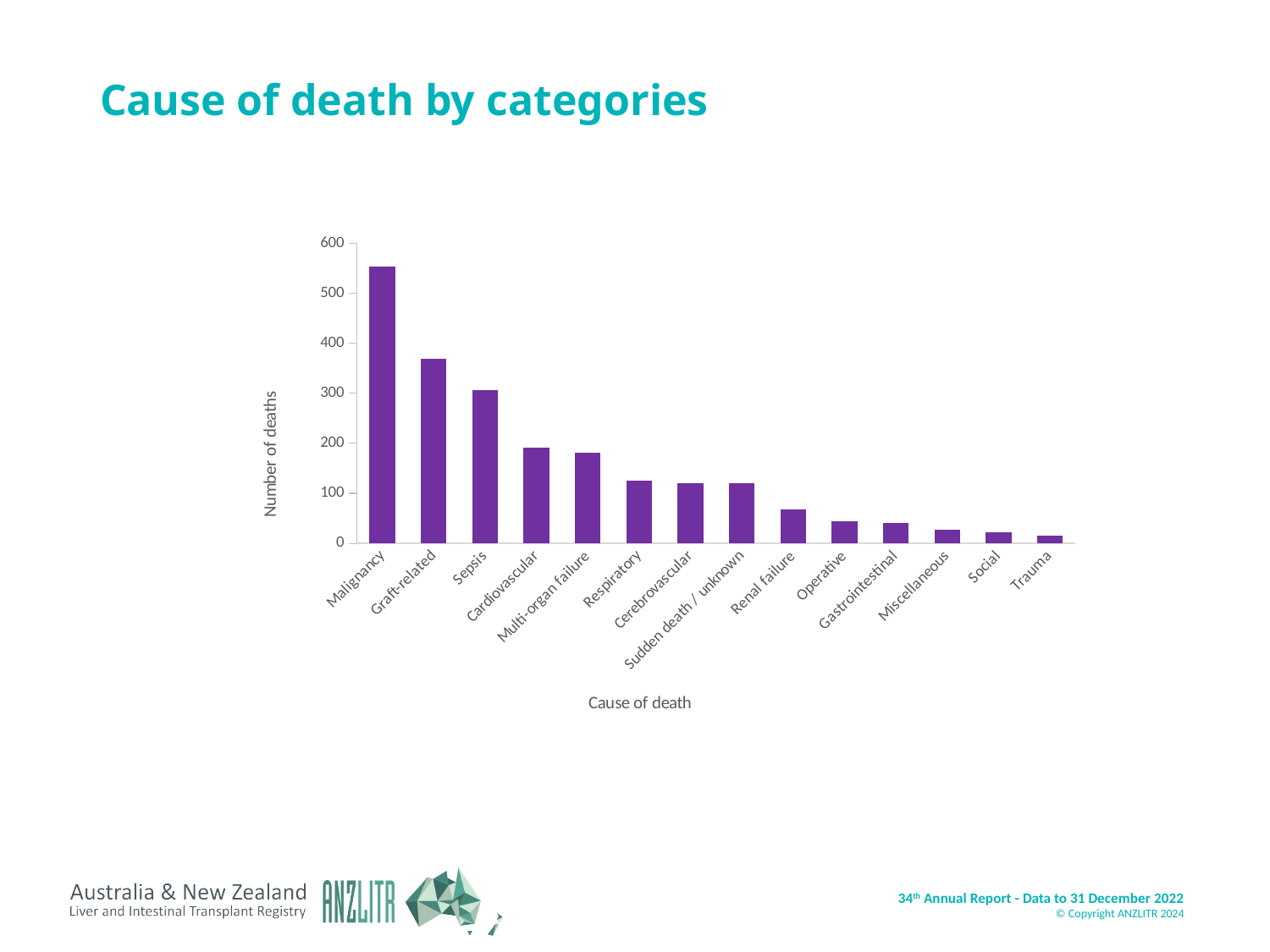
What kind of chart is shown on the slide? Bar chart Which cause of death has the lowest number of deaths? Trauma Is the number of deaths for Malignancy greater or less than 500? greater How many cause-of-death categories are shown on the x axis? 14 Is the number of deaths for Graft-related greater or less than 400? less Which has more deaths, Sepsis or Cardiovascular? Sepsis Which cause of death has the highest number of deaths? Malignancy What is the label of the y axis? Number of deaths Is the number of deaths for Renal failure greater or less than 100? less Which has more deaths, Renal failure or Operative? Renal failure Do the number of deaths rise or fall moving from left to right along the x axis? Fall